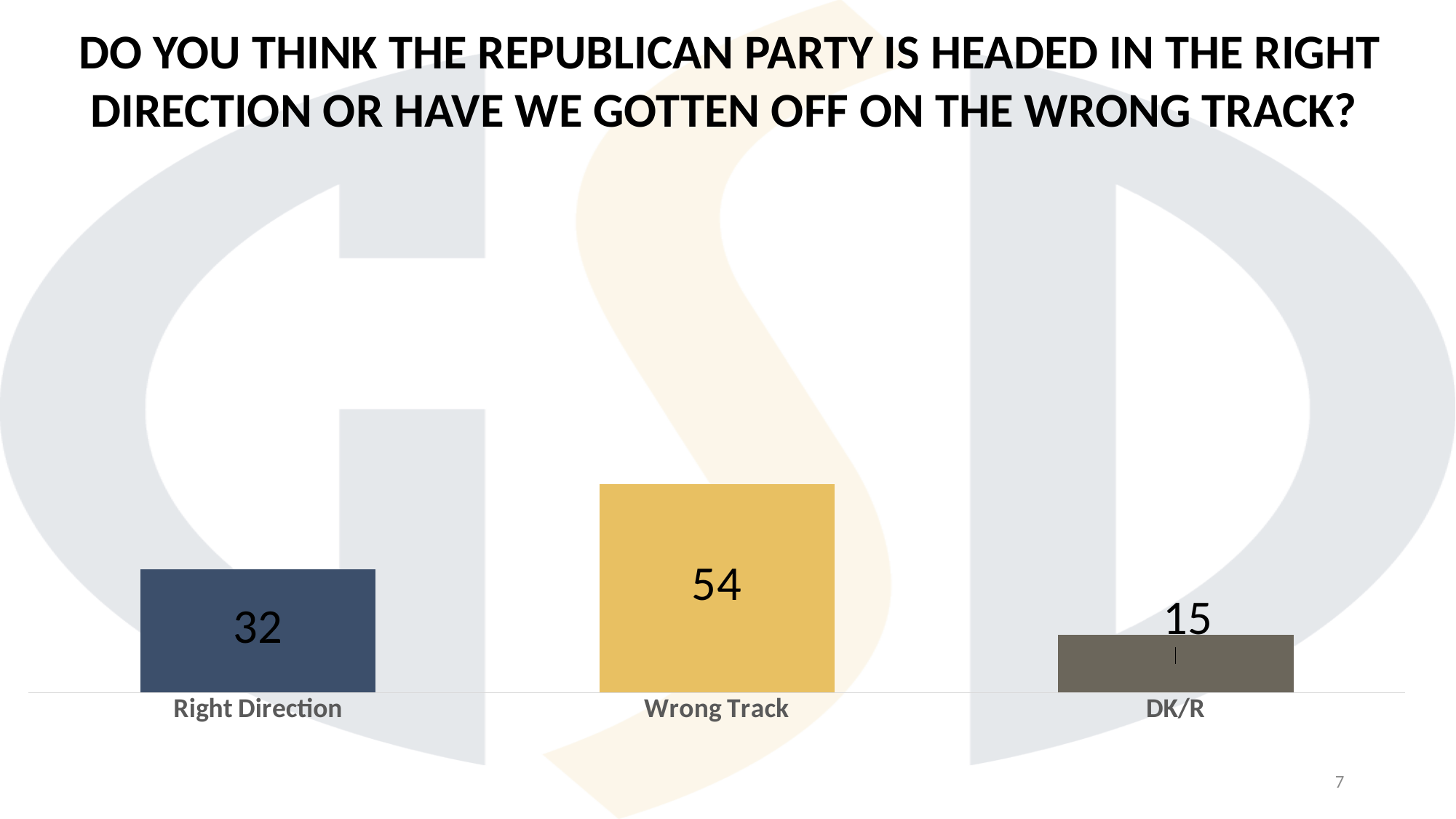
What is the difference between the values for Right Direction and DK/R? 17 What is the value for Right Direction? 32 What is the total of the three values shown in the chart? 101 What is the difference between the values for Wrong Track and Right Direction? 22 Which is larger, the value for Right Direction or the value for DK/R? Right Direction What is the value for DK/R? 15 What kind of chart is shown on the slide? bar chart Which category has the lowest value? DK/R Which category has the highest value? Wrong Track What is the value for Wrong Track? 54 What colour is the bar for Wrong Track? yellow How many categories are shown in the chart? 3